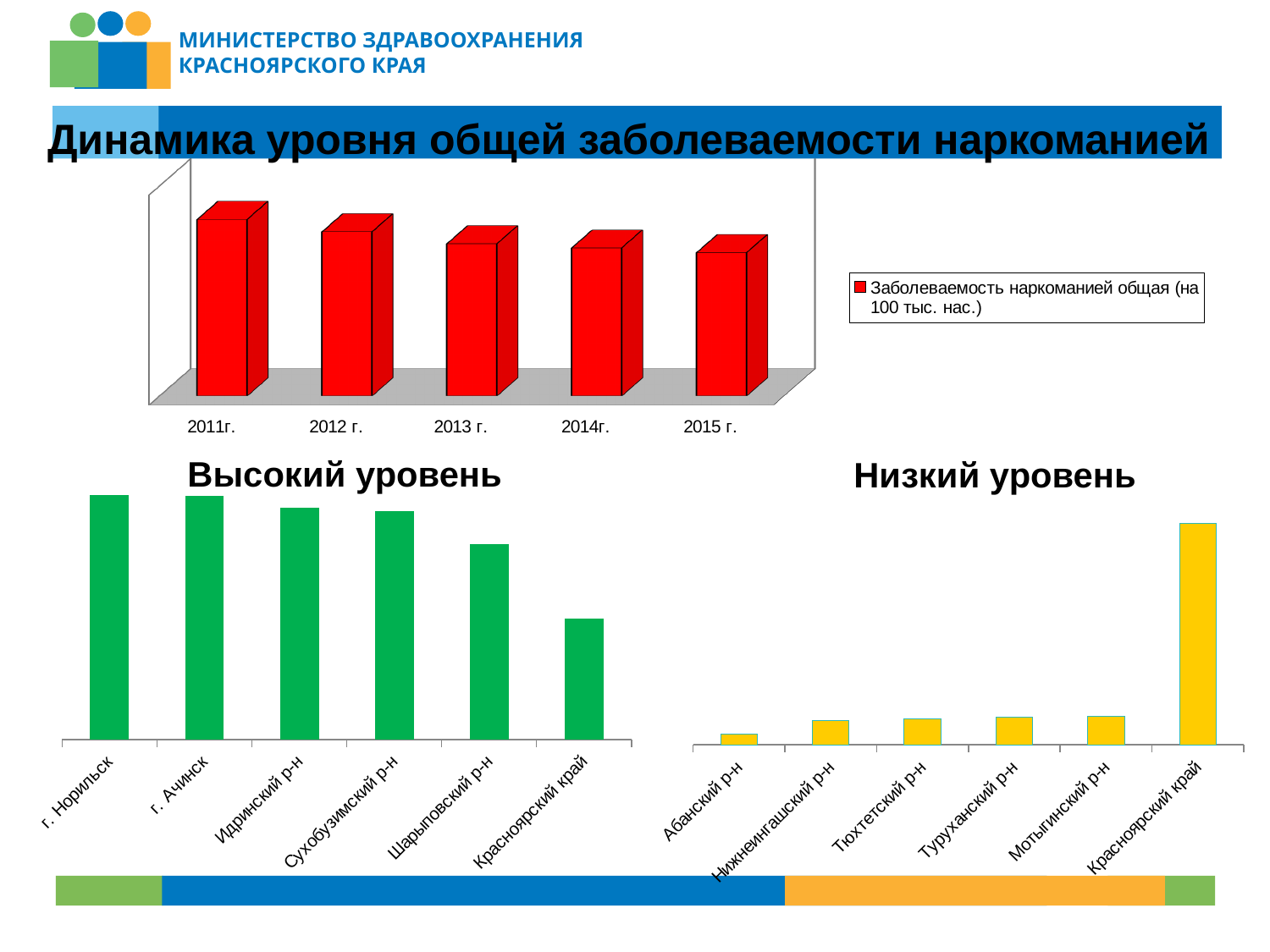
In the chart titled 'Динамика уровня общей заболеваемости наркоманией', how many series does the legend list? 1 In the chart titled 'Динамика уровня общей заболеваемости наркоманией', which year has the highest value? 2011г. In the chart titled 'Низкий уровень', which category has the lowest value? Абанский р-н In the chart titled 'Динамика уровня общей заболеваемости наркоманией', which year has the lowest value? 2015 г. In the chart titled 'Высокий уровень', which category has the lowest value? Красноярский край In the chart titled 'Динамика уровня общей заболеваемости наркоманией', do the values rise or fall from 2011 to 2015? fall In the chart titled 'Динамика уровня общей заболеваемости наркоманией', how many years are shown on the x axis? 5 In the chart titled 'Низкий уровень', which category has the highest value? Красноярский край In the chart titled 'Динамика уровня общей заболеваемости наркоманией', what is the legend entry? Заболеваемость наркоманией общая (на 100 тыс. нас.) In the chart titled 'Динамика уровня общей заболеваемости наркоманией', which is larger, the value for 2012 г. or for 2013 г.? 2012 г. In the chart titled 'Высокий уровень', which is larger, the value for Идринский р-н or for Шарыповский р-н? Идринский р-н In the chart titled 'Высокий уровень', how many categories are shown? 6